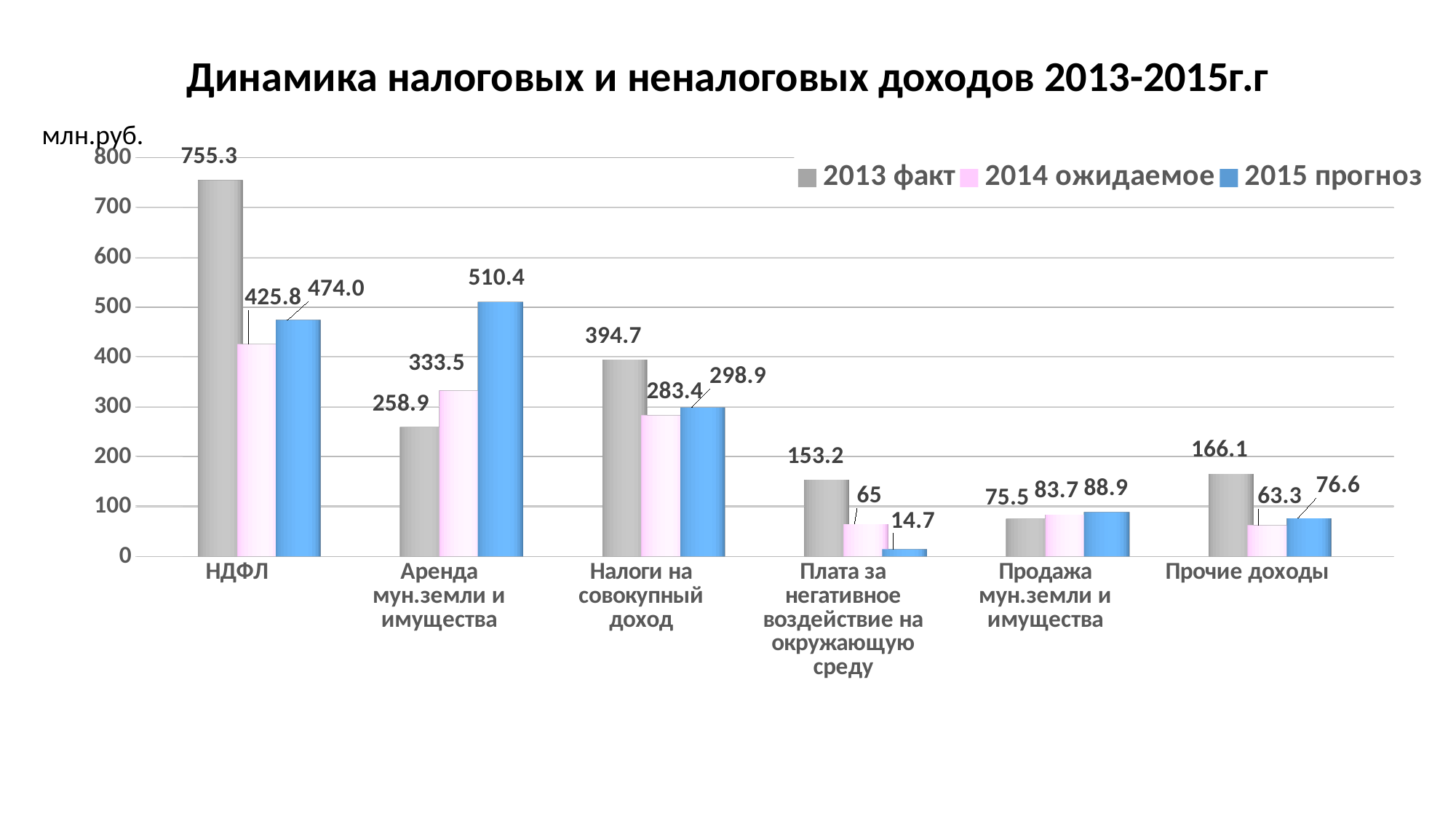
What kind of chart is shown on the slide? bar chart Which category has the lowest 2015 прогноз value? Плата за негативное воздействие на окружающую среду What is the 2015 прогноз value for Аренда мун.земли и имущества? 510.4 What is the difference between the 2013 факт and 2014 ожидаемое values for Налоги на совокупный доход? 111.3 What is the 2013 факт value for НДФЛ? 755.3 What is the 2014 ожидаемое value for Плата за негативное воздействие на окружающую среду? 65 Which has the larger 2015 прогноз value: Продажа мун.земли и имущества or Прочие доходы? Продажа мун.земли и имущества How many categories are shown on the x axis? 6 Which category has the highest 2013 факт value? НДФЛ How many series does the legend list? 3 What is the difference between the 2015 прогноз and 2014 ожидаемое values for НДФЛ? 48.2 What is the title of the chart? Динамика налоговых и неналоговых доходов 2013-2015г.г